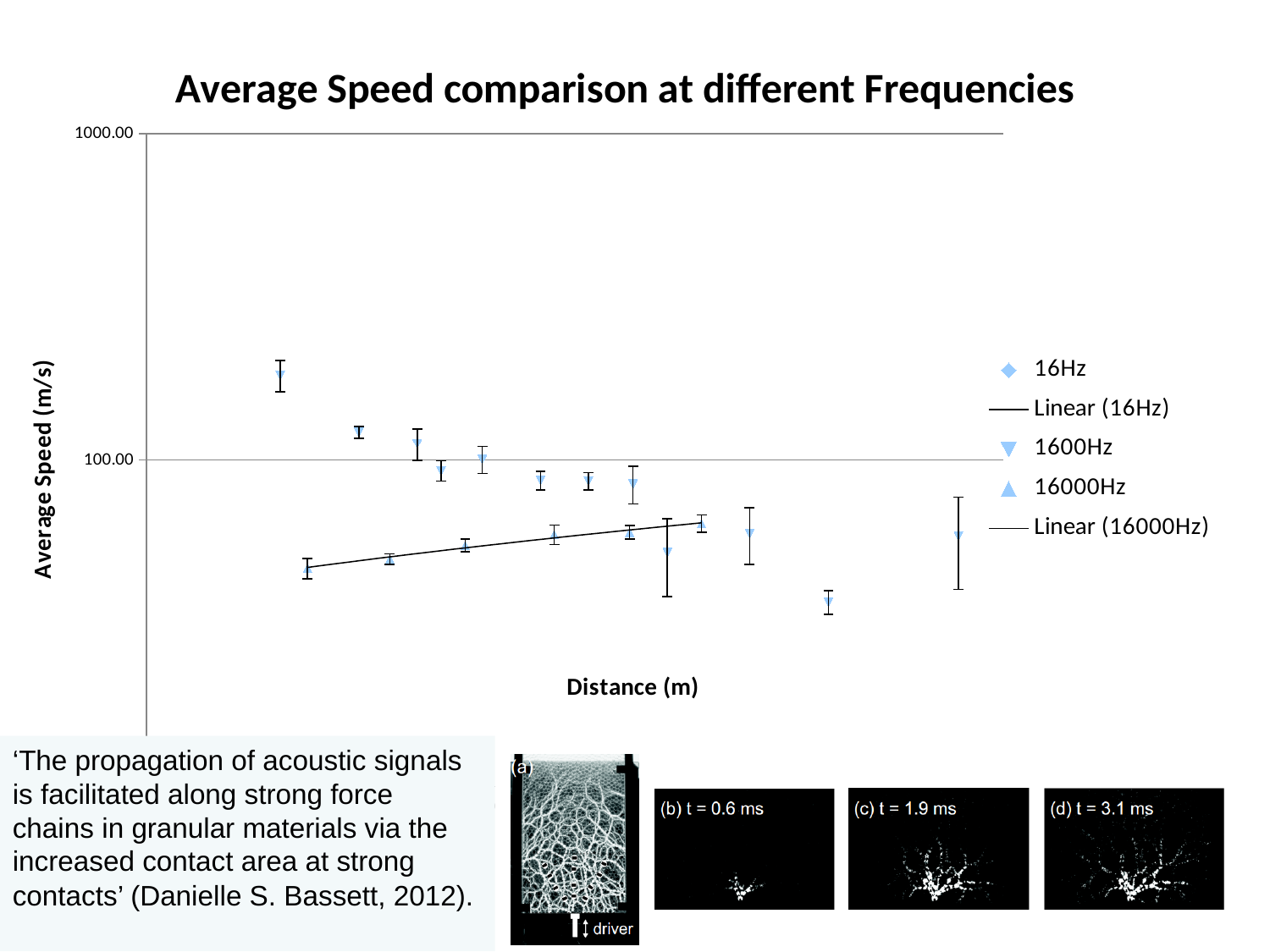
Are the points lying along the fitted linear trend line greater or less than 100.00 m/s? less What is the title of the chart? Average Speed comparison at different Frequencies Do the values of the 1600Hz series rise or fall as distance increases along the x axis? fall Does the fitted linear trend line drawn through the lower series rise or fall from left to right? rises Is the lowest plotted point on the chart greater or less than 100.00 m/s? less Is the leftmost 1600Hz point greater or less than 100.00 m/s? greater What is the label of the vertical axis? Average Speed (m/s) How many entries does the chart legend list? 5 What kind of chart is shown on the slide? scatter chart